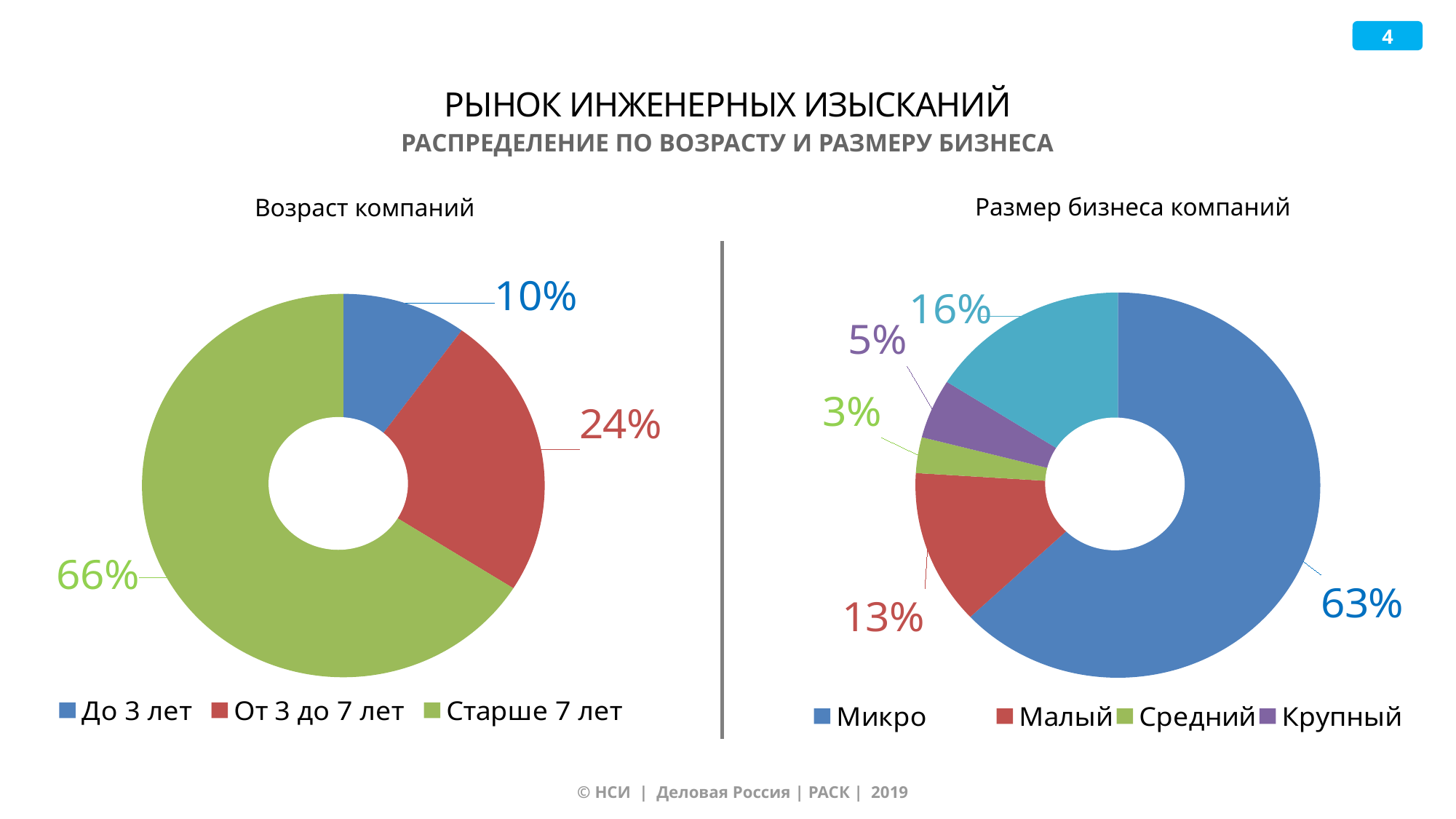
What type of chart is the 'Возраст компаний' chart? Doughnut (pie) chart In the 'Возраст компаний' chart, what is the difference between the shares of 'От 3 до 7 лет' and 'До 3 лет'? 14% In the 'Размер бизнеса компаний' chart, which is larger: 'Малый' or 'Средний'? Малый In the 'Размер бизнеса компаний' chart, what is the difference between the shares of 'Микро' and 'Малый'? 50% In the 'Возраст компаний' chart, what share is shown for 'Старше 7 лет'? 66% In the 'Возраст компаний' chart, which category has the smallest share? До 3 лет How many entries does the legend of the 'Размер бизнеса компаний' chart list? 4 In the 'Размер бизнеса компаний' chart, what share is shown for 'Микро'? 63% In the 'Возраст компаний' chart, which category has the largest share? Старше 7 лет In the 'Размер бизнеса компаний' chart, which category has the smallest share? Средний In the 'Размер бизнеса компаний' chart, what share is shown for 'Крупный'? 5% In the 'Возраст компаний' chart, what share is shown for 'До 3 лет'? 10%